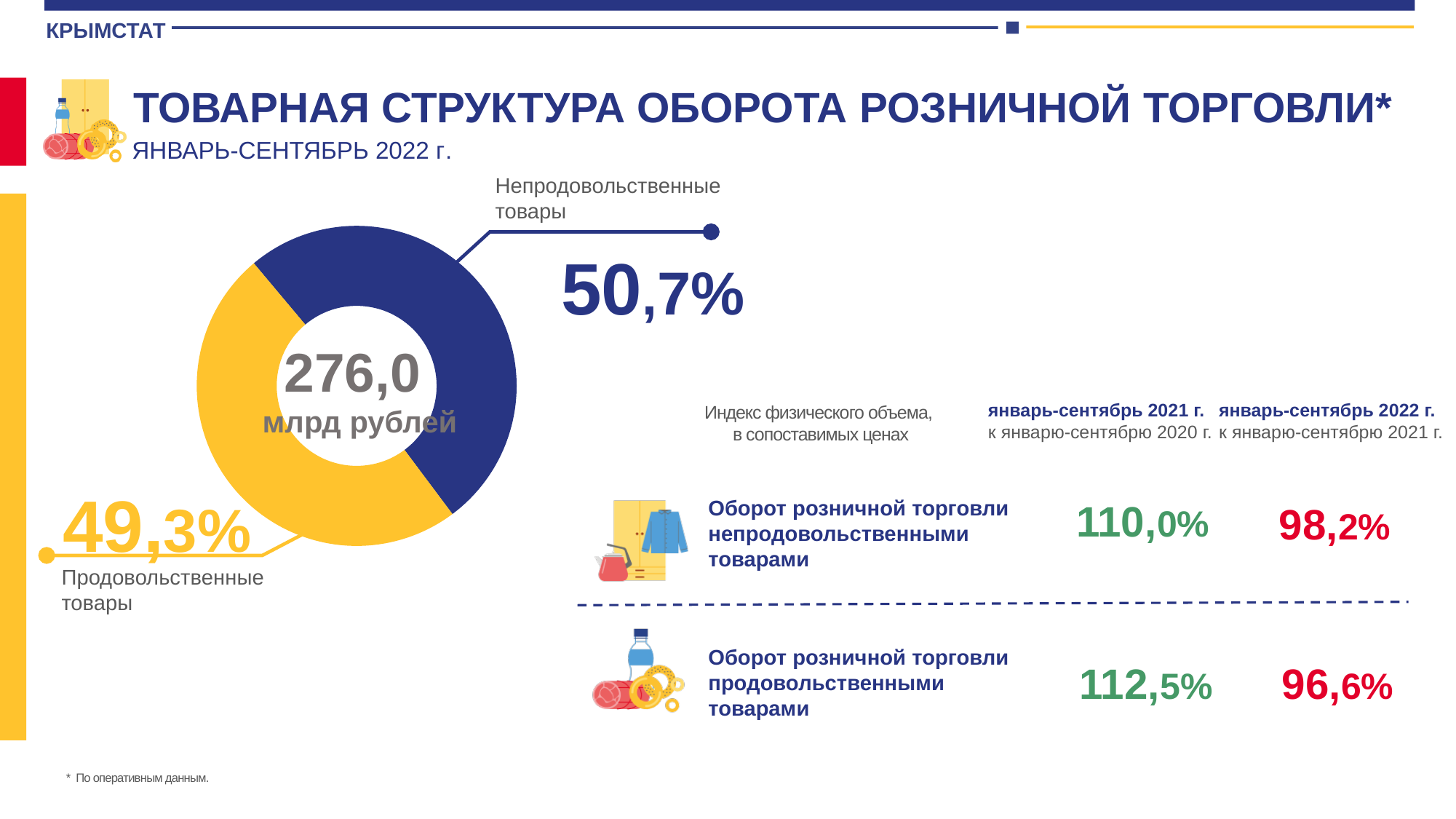
Which category has the larger share of retail trade turnover? Непродовольственные товары What kind of chart is shown on the slide? Pie (donut) chart What colour is the slice for non-food goods (Непродовольственные товары)? Dark blue Which category has the smaller share of retail trade turnover? Продовольственные товары What share of retail trade turnover do non-food goods (Непродовольственные товары) account for? 50,7% What colour is the slice for food goods (Продовольственные товары)? Yellow What total value is shown in the centre of the donut chart? 276,0 млрд рублей What share of retail trade turnover do food goods (Продовольственные товары) account for? 49,3% What period does the chart cover, according to the subtitle? Январь-сентябрь 2022 г. By how many percentage points does the share of non-food goods exceed the share of food goods? 1,4 How many categories does the donut chart show? 2 Which is larger: the share of food goods or the share of non-food goods? Non-food goods (Непродовольственные товары)